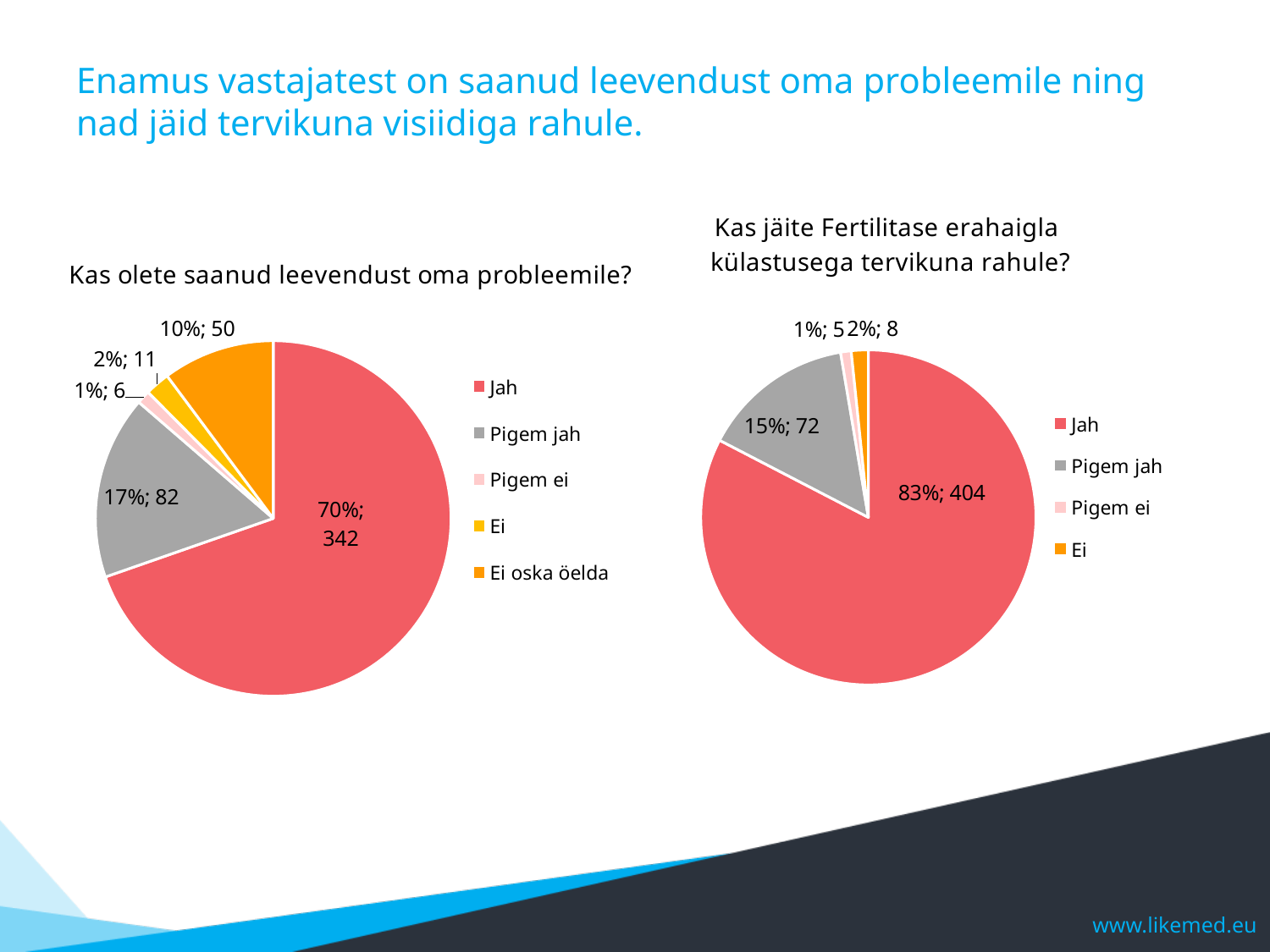
In the left chart (Kas olete saanud leevendust oma probleemile?), what is the value for Jah? 70%; 342 In the right chart (Kas jäite Fertilitase erahaigla külastusega tervikuna rahule?), what is the value for Jah? 83%; 404 In the right chart (Kas jäite Fertilitase erahaigla külastusega tervikuna rahule?), which is larger, Pigem jah or Ei? Pigem jah In the left chart (Kas olete saanud leevendust oma probleemile?), how many categories does the legend list? 5 In the right chart (Kas jäite Fertilitase erahaigla külastusega tervikuna rahule?), how many categories does the legend list? 4 In the right chart (Kas jäite Fertilitase erahaigla külastusega tervikuna rahule?), which category has the largest slice? Jah In the left chart (Kas olete saanud leevendust oma probleemile?), how many respondents answered Pigem jah? 82 In the left chart (Kas olete saanud leevendust oma probleemile?), what share of the pie is Ei oska öelda? 10% In the left chart (Kas olete saanud leevendust oma probleemile?), what is the difference in respondent count between Jah and Pigem jah? 260 In the right chart (Kas jäite Fertilitase erahaigla külastusega tervikuna rahule?), how many respondents answered Ei? 8 What type of chart is used on the slide? Pie chart In the left chart (Kas olete saanud leevendust oma probleemile?), which category has the smallest slice? Pigem ei